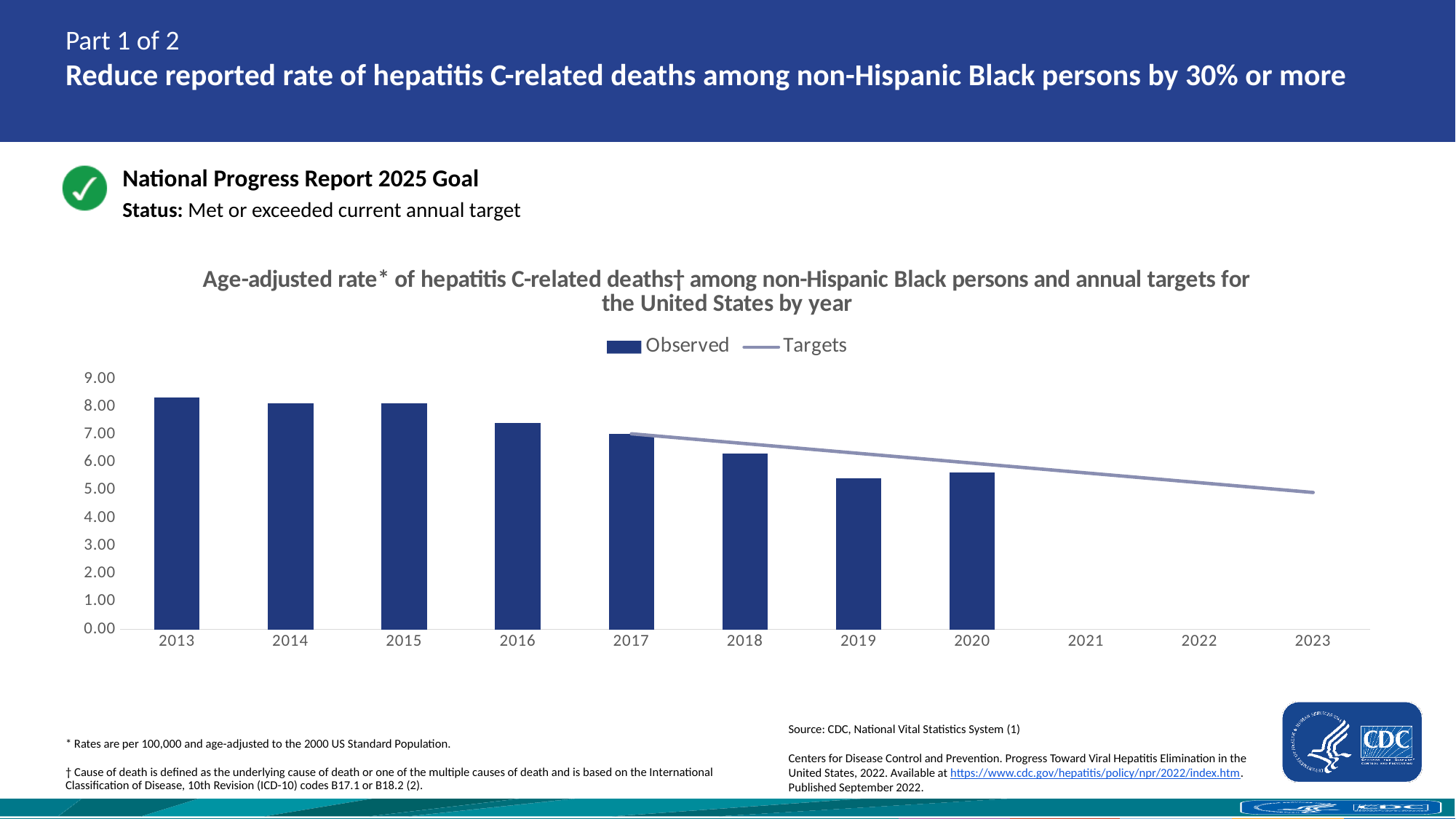
Which year has the highest Observed bar? 2013 Which is larger, the Observed value for 2014 or for 2019? 2014 How many year labels appear on the x axis? 11 How many years have an Observed bar plotted? 8 Is the Observed value for 2018 greater or less than 6.00? greater What kind of chart is shown on the slide? Bar chart with a line How many series does the chart legend list? 2 Is the Observed value for 2020 greater or less than 6.00? less What are the two series named in the legend? Observed and Targets Do the Observed values generally rise or fall from 2013 to 2020? fall Is the Observed value for 2013 greater or less than 8.00? greater